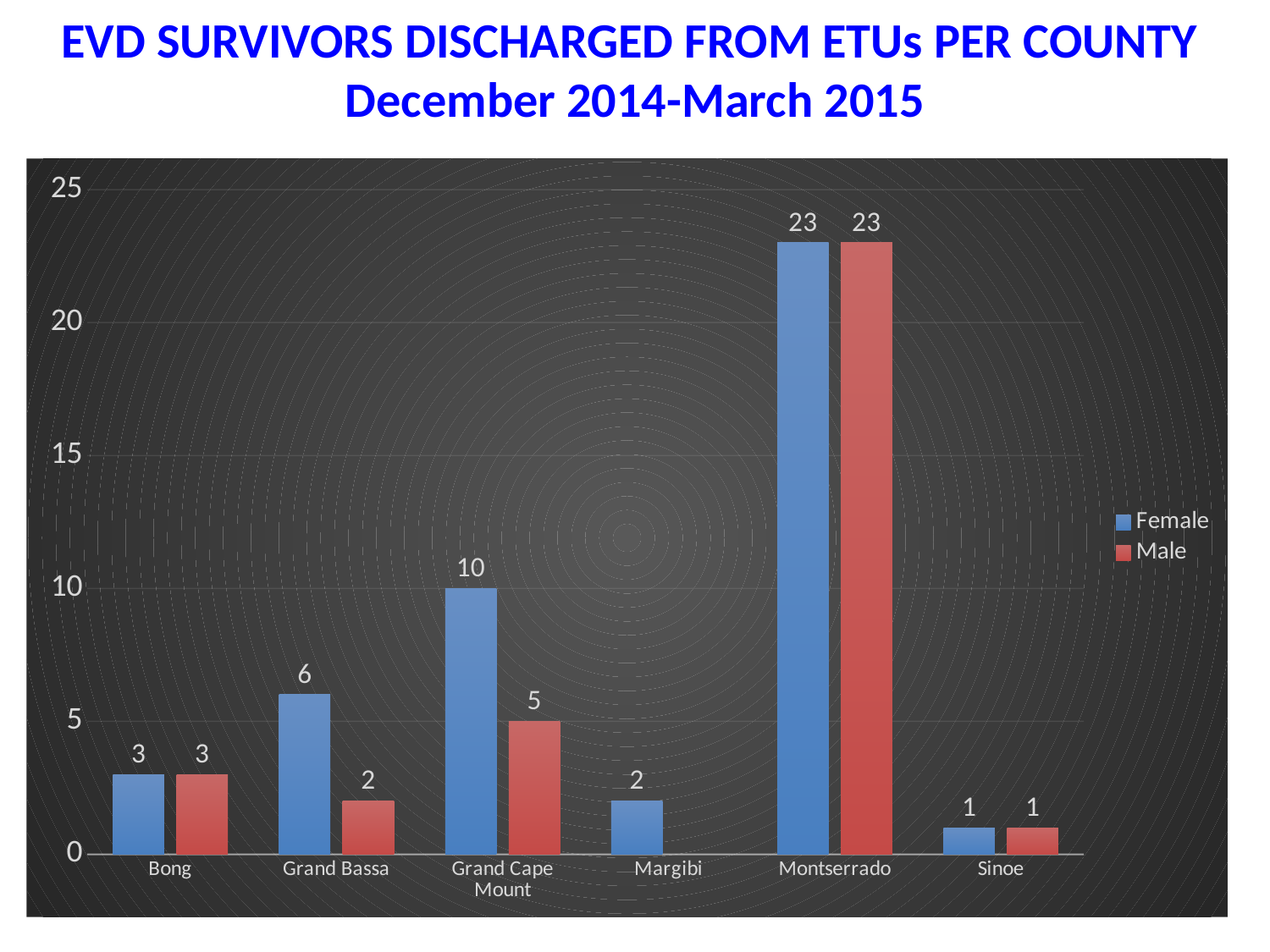
What is the Female value for Grand Cape Mount? 10 What is the Male value for Grand Bassa? 2 Is the Female value for Montserrado greater or less than 20? greater How many counties are shown on the x axis? 6 Which county has the highest Female value? Montserrado What is the difference between the Female and Male values for Grand Cape Mount? 5 How many series does the legend list? 2 What kind of chart is shown on the slide? Bar chart What is the Female value for Margibi? 2 Which county has the lowest Male value? Sinoe Which is larger for Grand Bassa, the Female value or the Male value? Female Which colour represents the Male series? Red